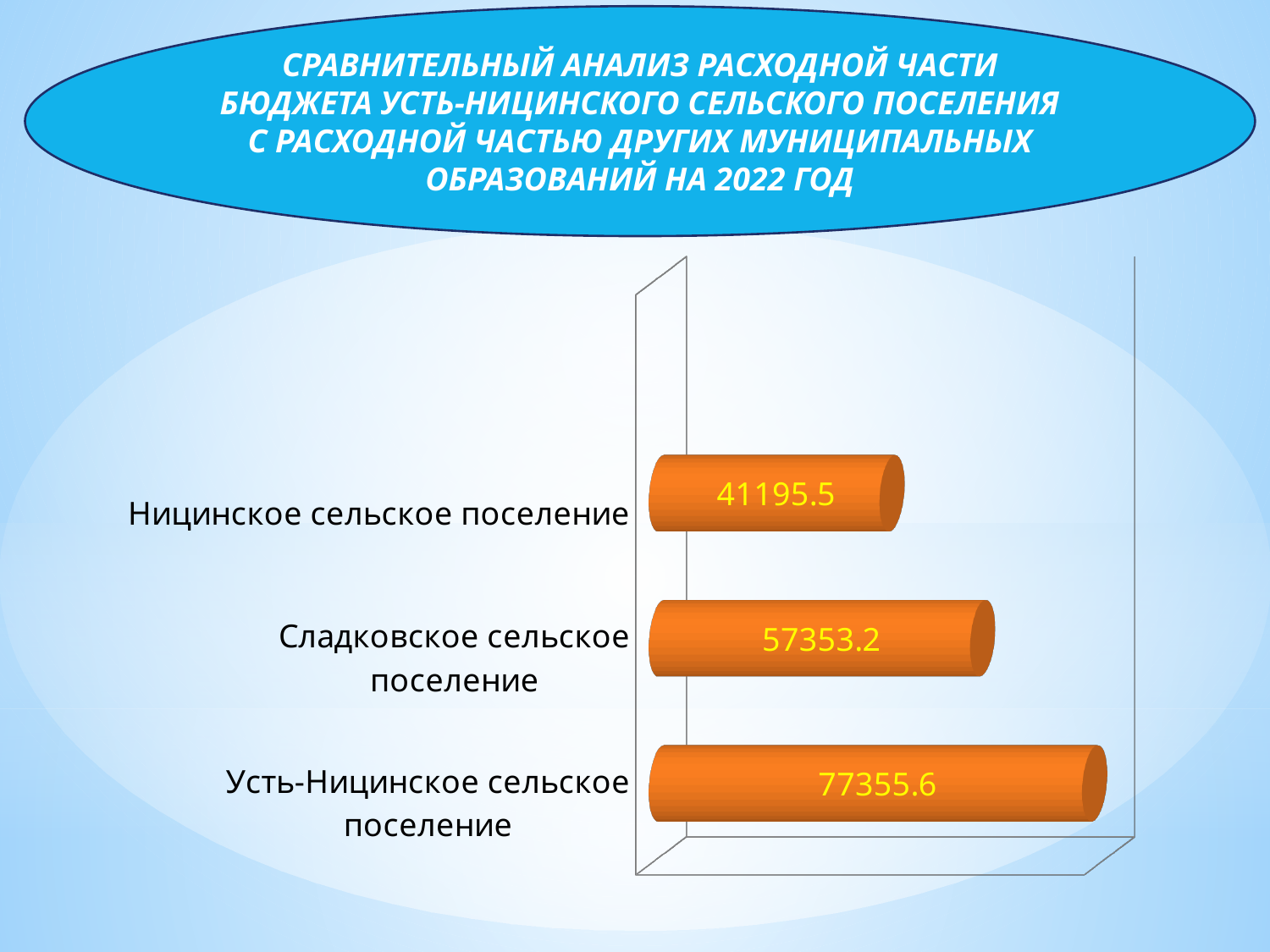
What is the value for Ницинское сельское поселение? 41195.5 What is the difference between the values for Усть-Ницинское сельское поселение and Ницинское сельское поселение? 36160.1 What is the value for Усть-Ницинское сельское поселение? 77355.6 How many categories are shown in the chart? 3 Which category has the lowest value? Ницинское сельское поселение Which category has the highest value? Усть-Ницинское сельское поселение What is the difference between the values for Сладковское сельское поселение and Ницинское сельское поселение? 16157.7 What kind of chart is shown on the slide? Bar chart What is the value for Сладковское сельское поселение? 57353.2 Which is larger, the value for Сладковское сельское поселение or the value for Ницинское сельское поселение? Сладковское сельское поселение What colour are the bars in the chart? Orange What is the difference between the values for Усть-Ницинское сельское поселение and Сладковское сельское поселение? 20002.4